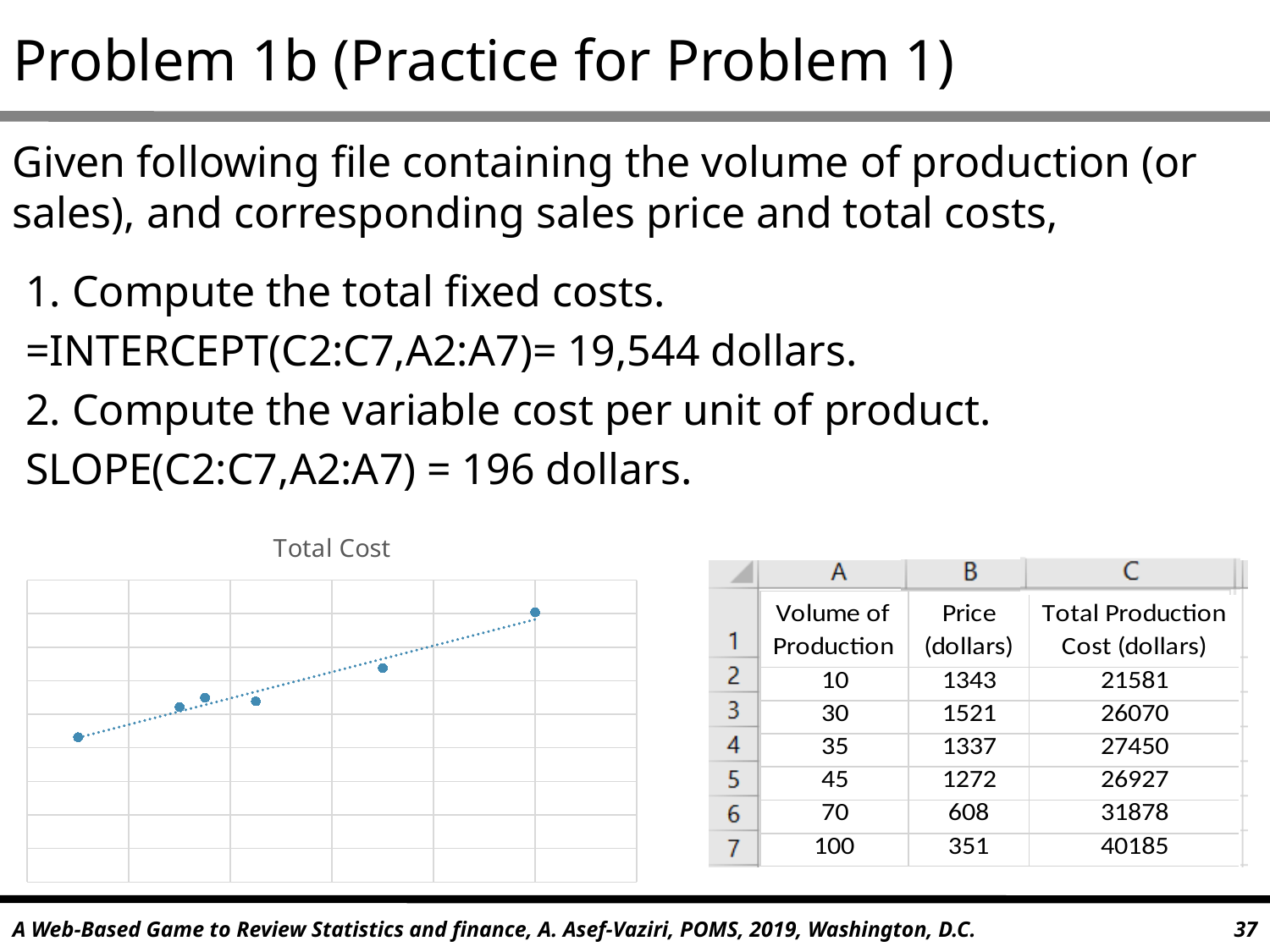
According to the data table beside the chart, which volume of production has the highest total production cost? 100 What kind of chart is the "Total Cost" chart? scatter chart What is the title of the chart on the slide? Total Cost According to the data table beside the chart, which has the larger total production cost: volume 35 or volume 45? 35 According to the data table beside the chart, what is the price at a volume of production of 30? 1521 According to the data table beside the chart, what is the difference between the total production cost at volume 100 and at volume 10? 18604 According to the data table beside the chart, what is the total production cost at a volume of production of 70? 31878 Do the points in the "Total Cost" chart rise or fall from left to right? rise How many data points are plotted in the "Total Cost" chart? 6 What style of line is drawn through the points in the "Total Cost" chart? dotted trendline According to the data table beside the chart, which volume of production has the lowest total production cost? 10